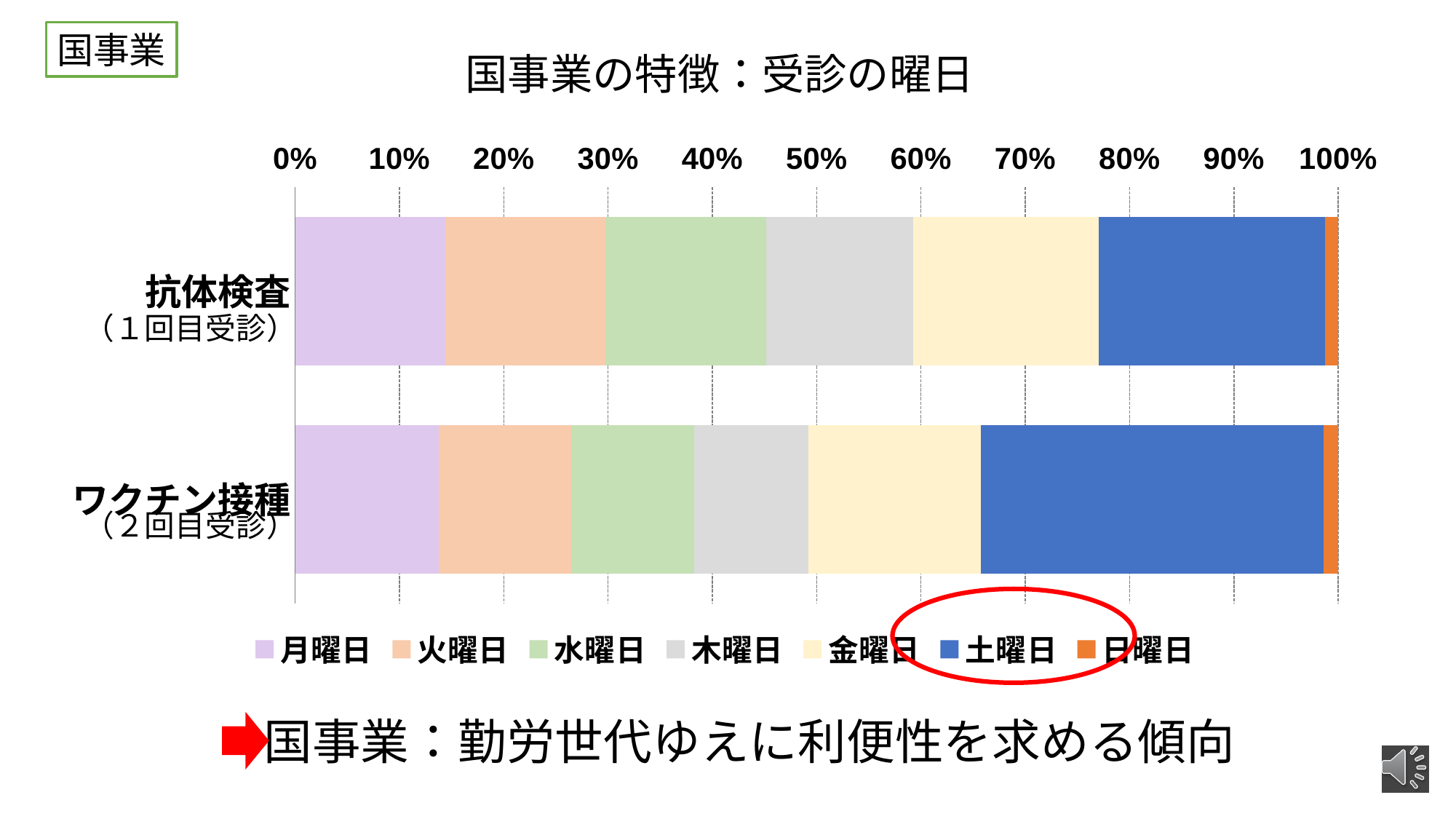
How many series does the legend list? 7 Which day of the week has the largest segment in the ワクチン接種（2回目受診） bar? 土曜日 Is the 日曜日 share of the 抗体検査（1回目受診） bar greater or less than 10%? less Which day of the week has the largest segment in the 抗体検査（1回目受診） bar? 土曜日 How many categories (bars) does the chart show? 2 Which bar has the larger 土曜日 share, 抗体検査（1回目受診） or ワクチン接種（2回目受診）? ワクチン接種（2回目受診） Which legend entry is circled in red? 土曜日 Which day of the week has the smallest segment in the ワクチン接種（2回目受診） bar? 日曜日 Is the 土曜日 share of the 抗体検査（1回目受診） bar greater or less than 30%? less What kind of chart is shown on the slide? Stacked bar chart Is the 土曜日 share of the ワクチン接種（2回目受診） bar greater or less than 30%? greater What is the title of the chart? 国事業の特徴：受診の曜日